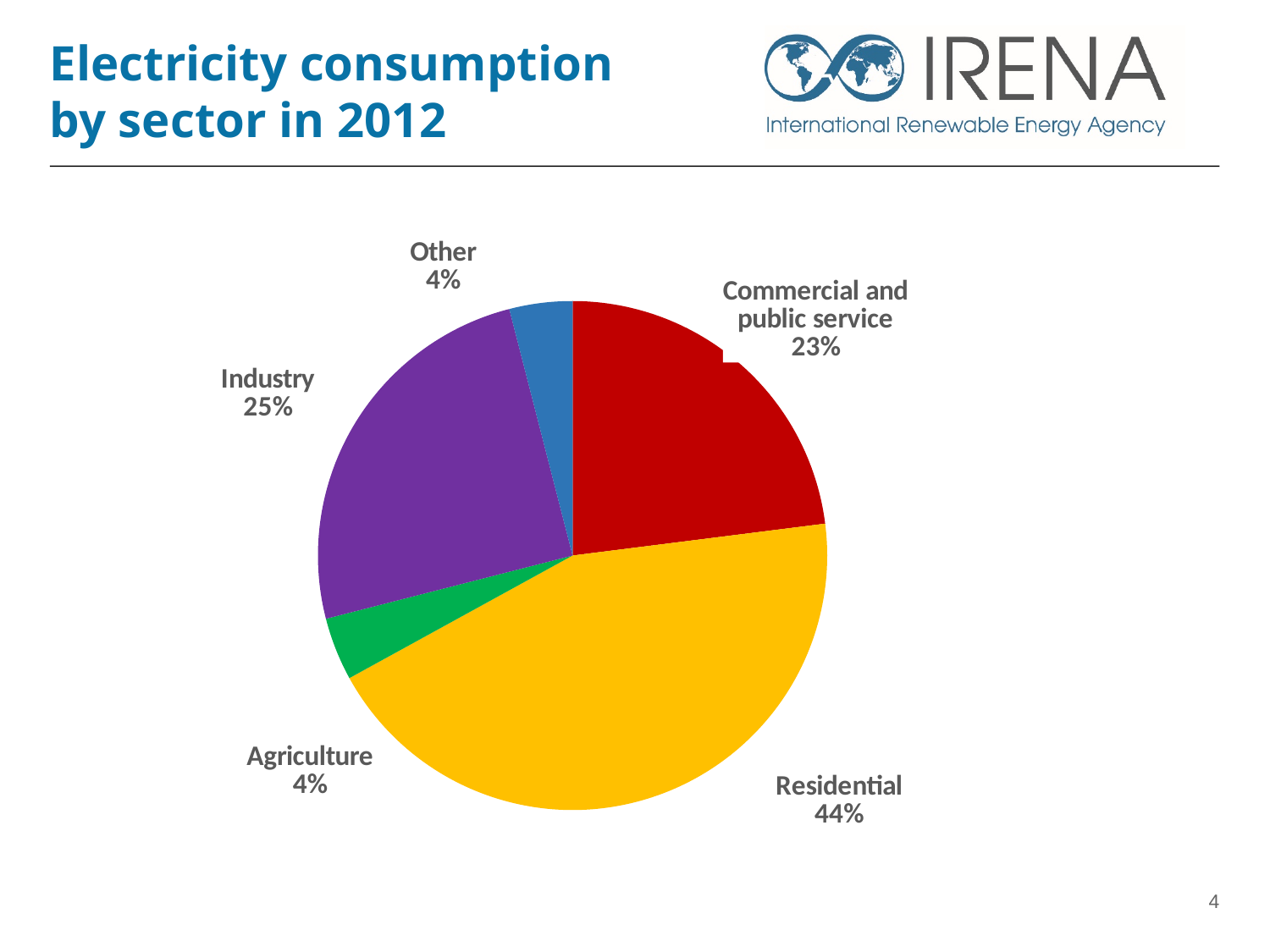
What kind of chart is shown on the slide? Pie chart What is the title of the slide? Electricity consumption by sector in 2012 What share of electricity consumption does Agriculture account for? 4% What share of electricity consumption does Commercial and public service account for? 23% What is the difference in percentage points between the Industry and Commercial and public service shares? 2 What share of electricity consumption does Industry account for? 25% Which sector has the largest share of electricity consumption? Residential How many sectors are shown in the pie chart? 5 Which has a larger share, Industry or Commercial and public service? Industry What share of electricity consumption does the Residential sector account for? 44% What colour is the Residential slice? Yellow What is the difference in percentage points between the Residential and Industry shares? 19